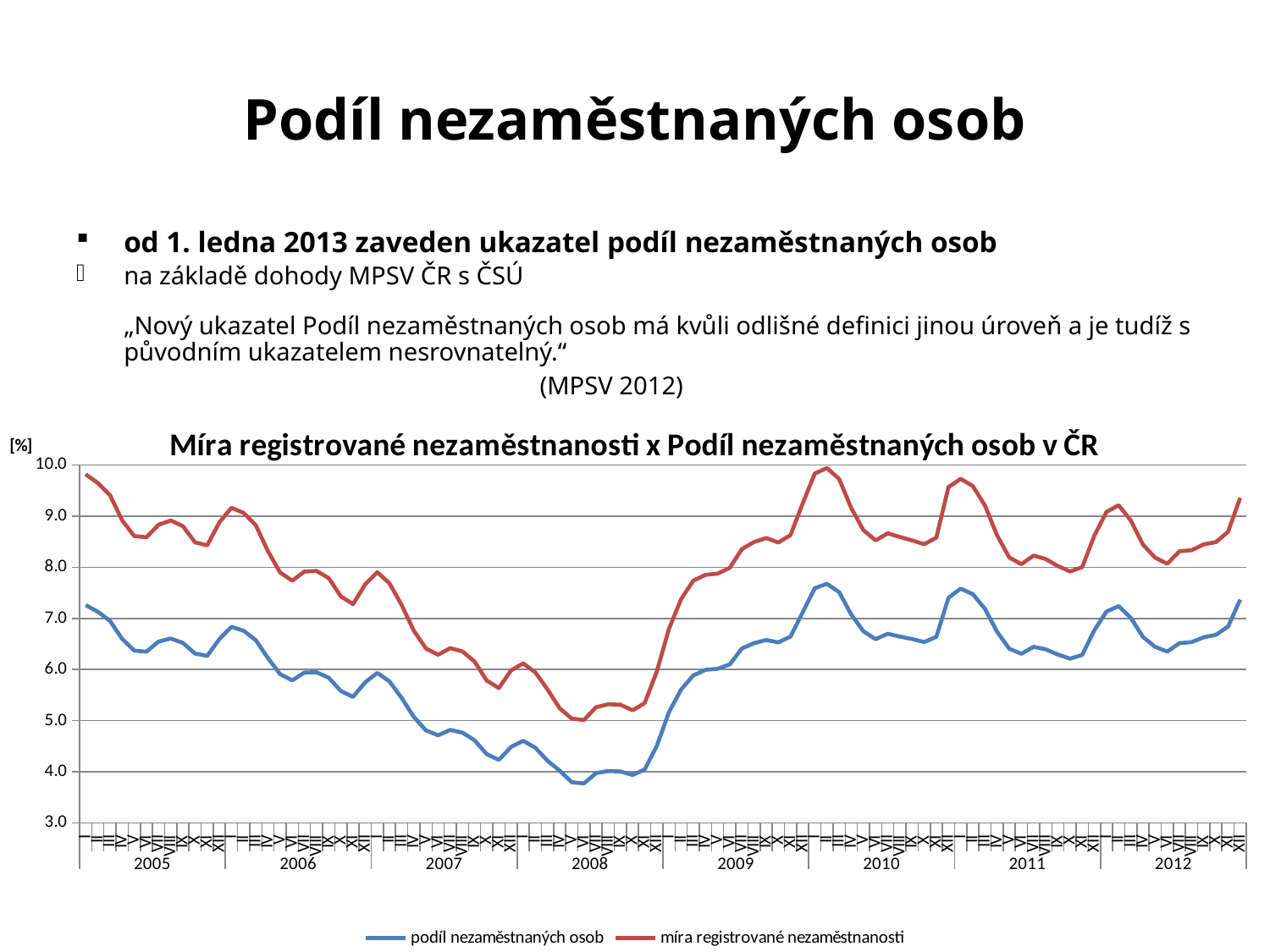
Is the peak value of míra registrované nezaměstnanosti in 2009 greater or less than 9.0? greater Do the values of míra registrované nezaměstnanosti rise or fall from 2008 to 2009? rise What kind of chart is shown on the slide? line chart Which series is drawn in red in the chart? míra registrované nezaměstnanosti Which series has the higher values throughout the chart, podíl nezaměstnaných osob or míra registrované nezaměstnanosti? míra registrované nezaměstnanosti Is the value of míra registrované nezaměstnanosti at the start of 2005 greater or less than 9.0? greater Do the values of podíl nezaměstnaných osob rise or fall from 2005 to 2008? fall How many years are labelled on the x axis of the chart? 8 Is the lowest value of podíl nezaměstnaných osob in 2008 greater or less than 4.0? less What is the title of the chart? Míra registrované nezaměstnanosti x Podíl nezaměstnaných osob v ČR How many series does the chart legend list? 2